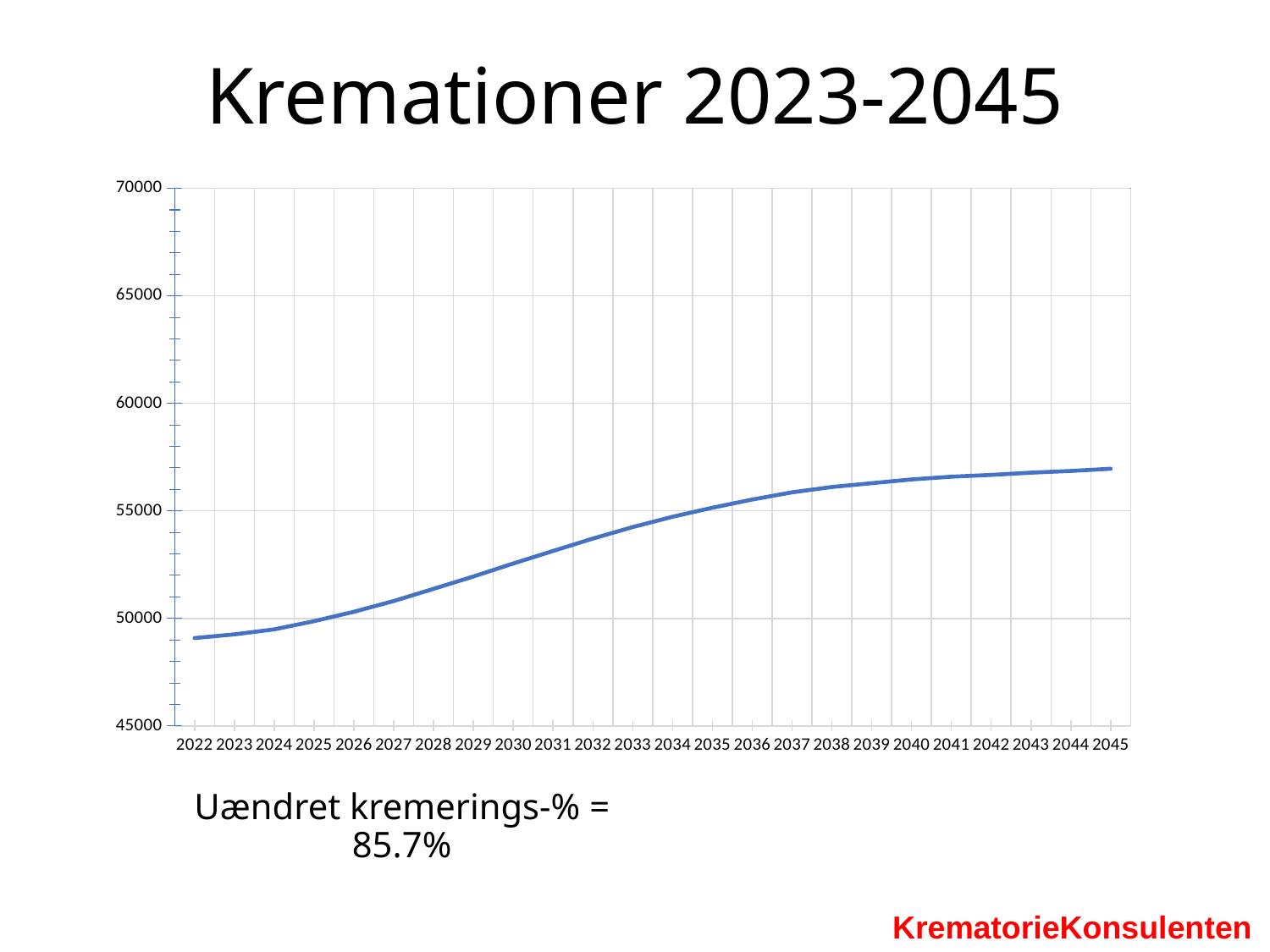
What kind of chart is shown on the slide? line chart Is the value for 2045 greater or less than 55000? greater How many years are shown on the x axis? 24 Is the value for 2022 greater or less than 50000? less What cremation percentage is stated in the text below the chart? 85.7% Do the values rise or fall along the x axis from 2022 to 2045? rise What is the title of the chart? Kremationer 2023-2045 Which year has the lowest value on the line? 2022 Is the value for 2030 greater or less than 55000? less Which year has the highest value on the line? 2045 Which year has the larger value, 2025 or 2040? 2040